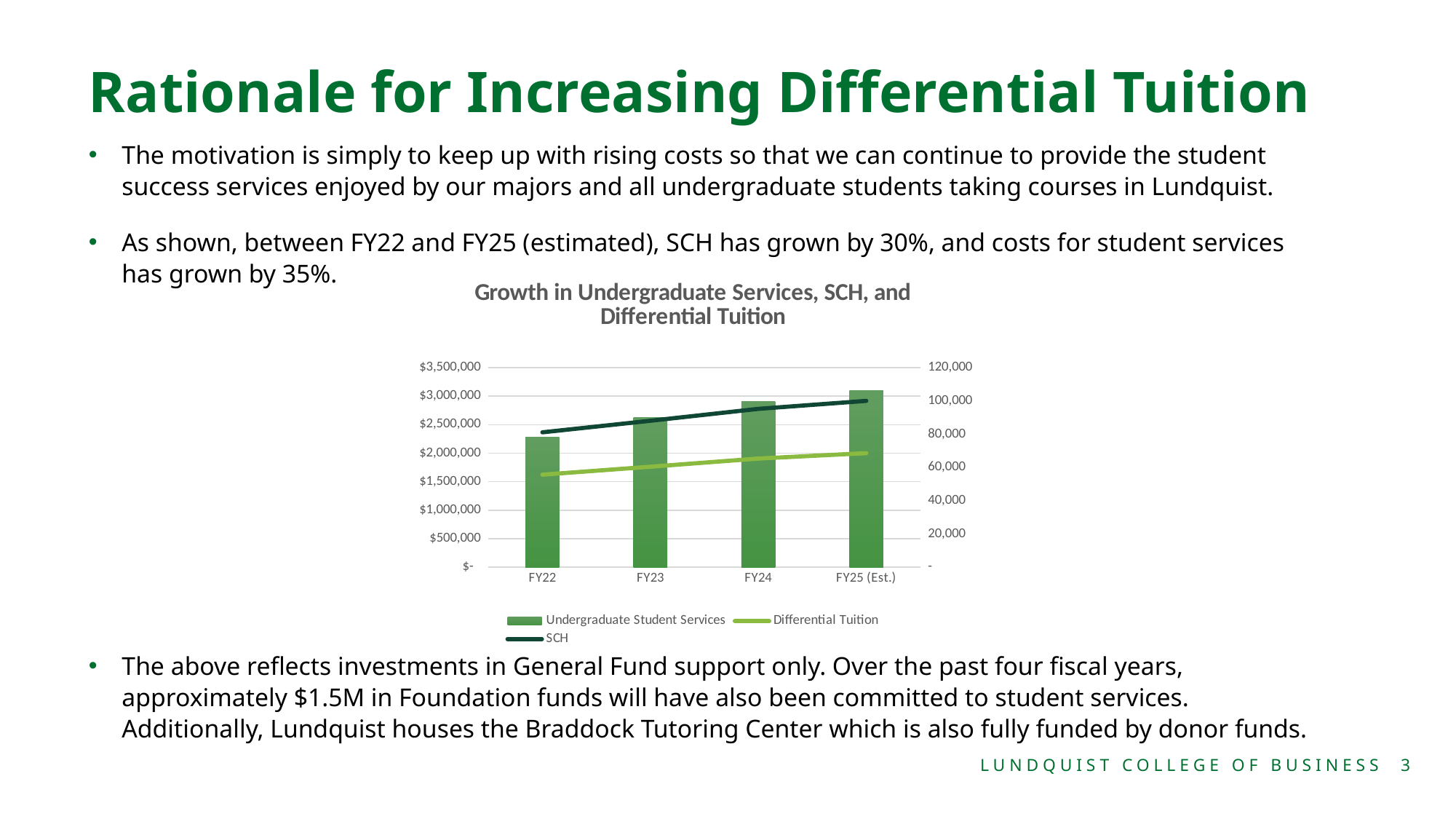
What kind of chart is shown on the slide? A combination bar and line chart Is the Undergraduate Student Services value for FY22 greater or less than $2,500,000? less Which fiscal year has the lowest Undergraduate Student Services bar? FY22 How many series does the chart legend list? 3 Which series in the chart is plotted as bars? Undergraduate Student Services Is the SCH value for FY22 greater or less than 100,000? less How many fiscal year categories are shown on the x axis of the chart? 4 Which fiscal year has the highest Undergraduate Student Services bar? FY25 (Est.) Do the Undergraduate Student Services bars rise or fall from FY22 to FY25 (Est.)? Rise What is the title of the chart? Growth in Undergraduate Services, SCH, and Differential Tuition Is the Undergraduate Student Services value for FY25 (Est.) greater or less than $3,000,000? greater Which series is higher on the right axis in FY24, SCH or Differential Tuition? SCH